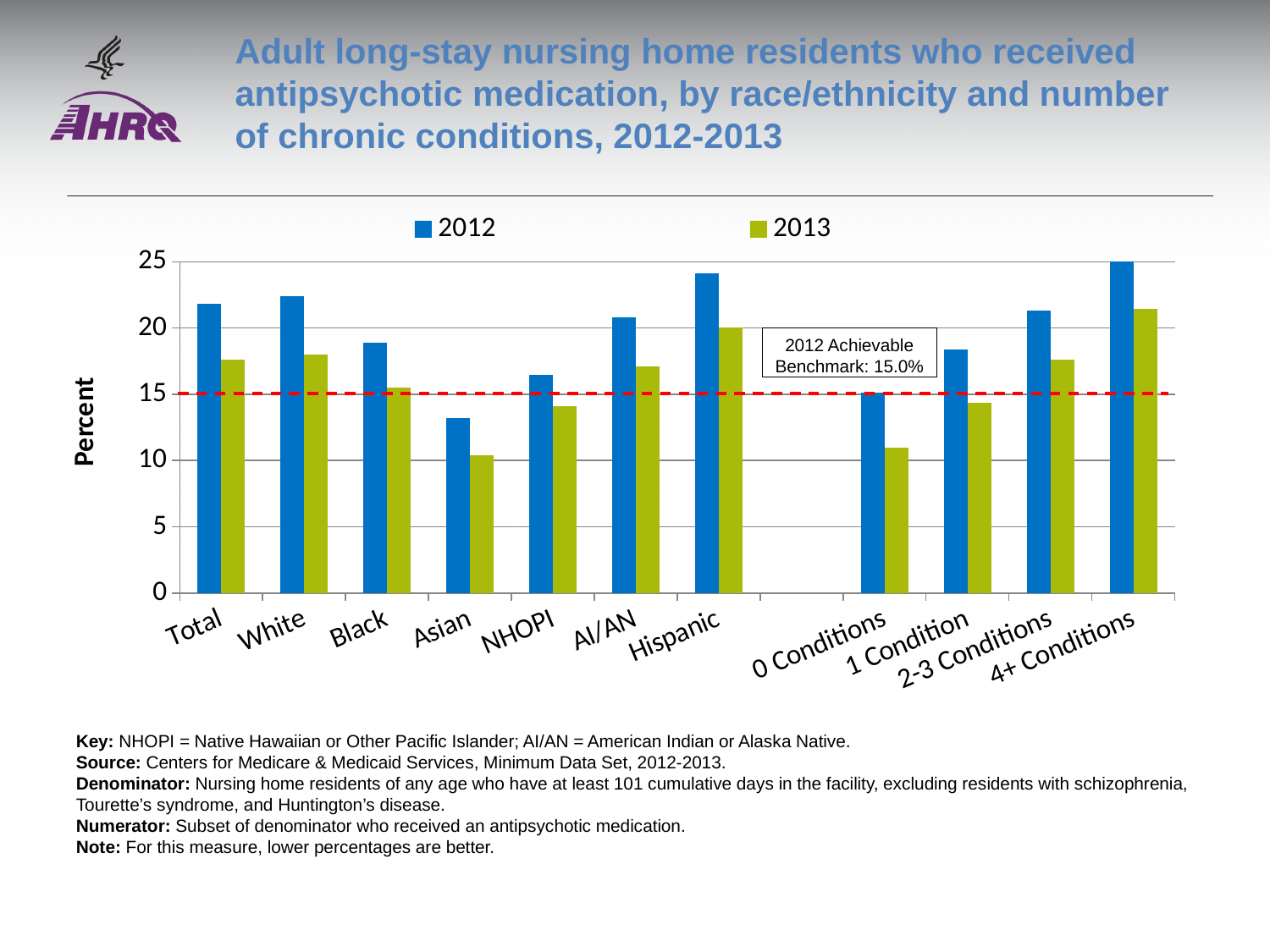
Is the 2012 value for Asian greater or less than 15? less How many categories are shown along the x axis? 11 Is the 2013 value for 0 Conditions greater or less than 15? less Across the number-of-conditions categories (0 Conditions to 4+ Conditions), do the 2013 values rise or fall? rise What kind of chart is shown on the slide? bar chart Which category has the highest 2013 value? 4+ Conditions What is the 2012 achievable benchmark shown on the chart? 15.0% Which category has the lowest 2012 value? Asian How many series does the legend list? 2 For Total, which year has the larger value, 2012 or 2013? 2012 Is the 2012 value for Hispanic greater or less than 20? greater Among the race/ethnicity groups, which has the highest 2012 value? Hispanic